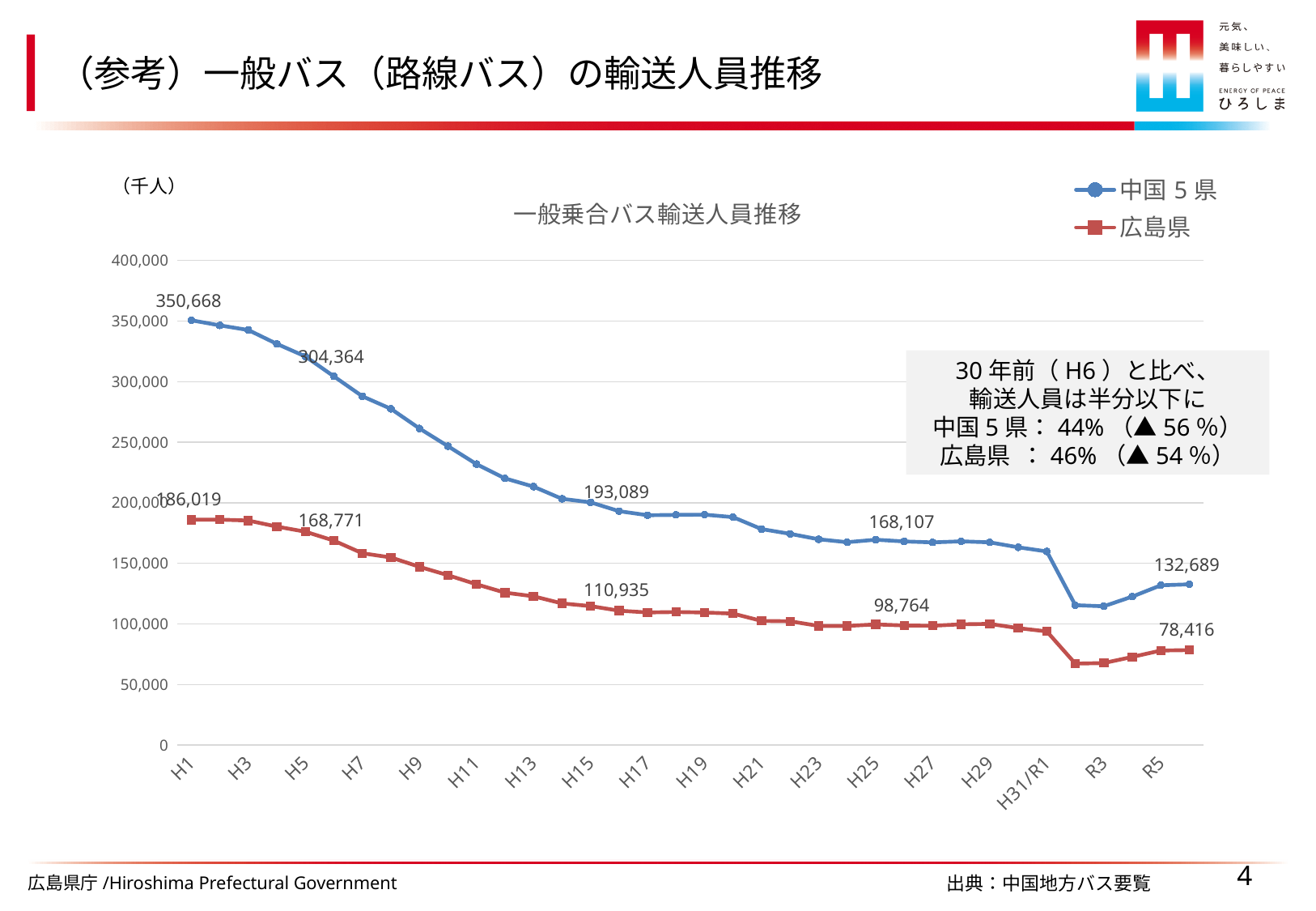
What is the value for 広島県 at H1? 186,019 By how much did the 中国5県 value fall from H1 (350,668) to the last data point (132,689)? 217,979 What is the value for 広島県 at the last data point on the right? 78,416 What is the value for 中国5県 at H6 (the labelled point between H5 and H7)? 304,364 What kind of chart is shown on the slide? line chart How many series does the legend list? 2 What is the difference between 中国5県 and 広島県 at H1? 164,649 What is the value for 中国5県 at the last data point on the right? 132,689 What is the value for 中国5県 at H1? 350,668 Which series has the higher value at H1, 中国5県 or 広島県? 中国5県 Do the values for 中国5県 generally rise or fall from H1 to R5? fall Is the value for 広島県 at R3 greater or less than 100,000? less